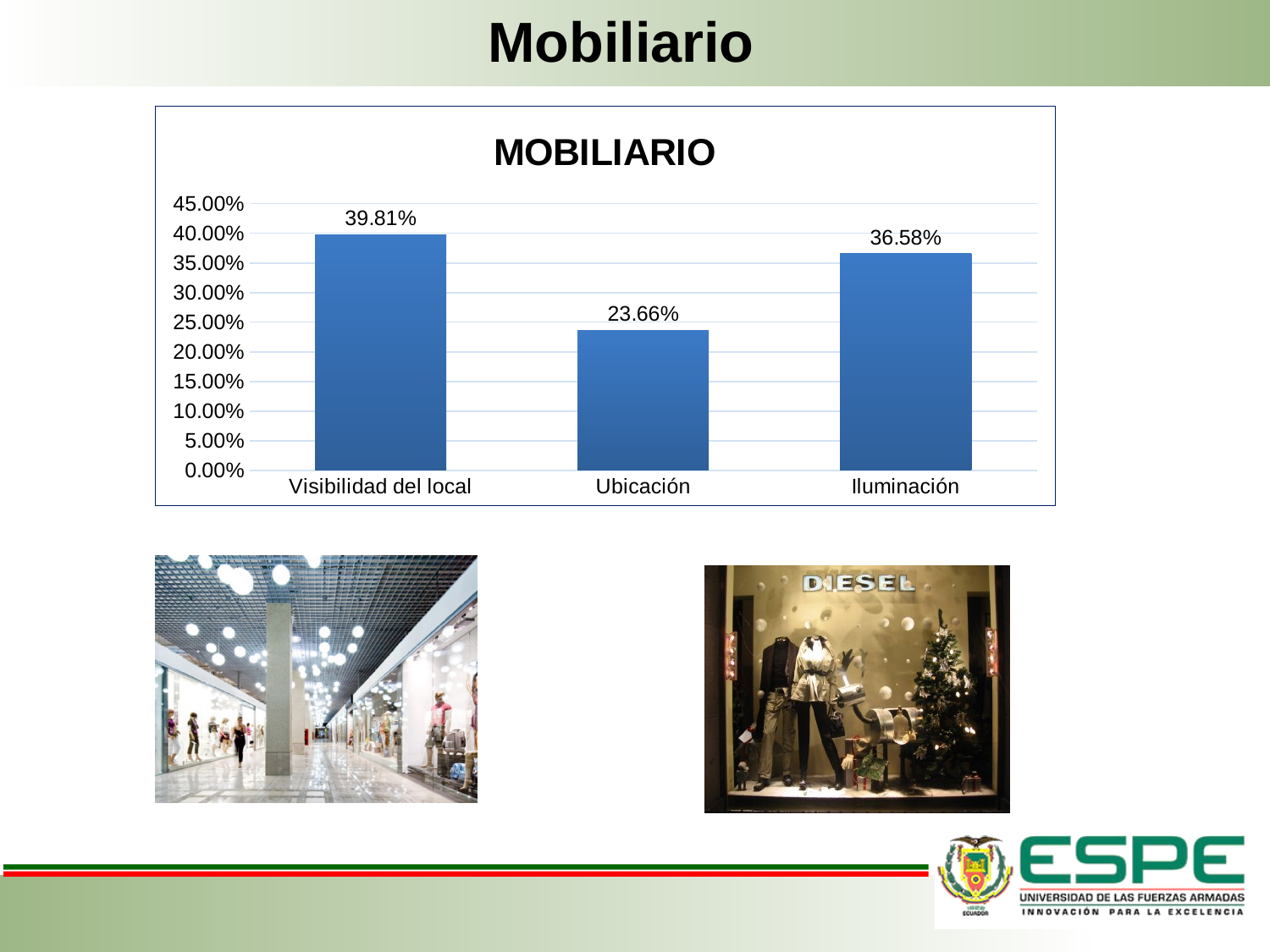
Which category has the highest value? Visibilidad del local What is the value for Ubicación? 23.66% Is the value for Ubicación greater or less than 25.00%? less How many categories are shown in the chart? 3 Which is larger, the value for Iluminación or the value for Ubicación? Iluminación Which category has the lowest value? Ubicación What kind of chart is shown on the slide? bar chart What is the title of the chart? MOBILIARIO What is the value for Visibilidad del local? 39.81% What is the value for Iluminación? 36.58% What is the difference between the values for Visibilidad del local and Ubicación? 16.15% What is the difference between the values for Visibilidad del local and Iluminación? 3.23%